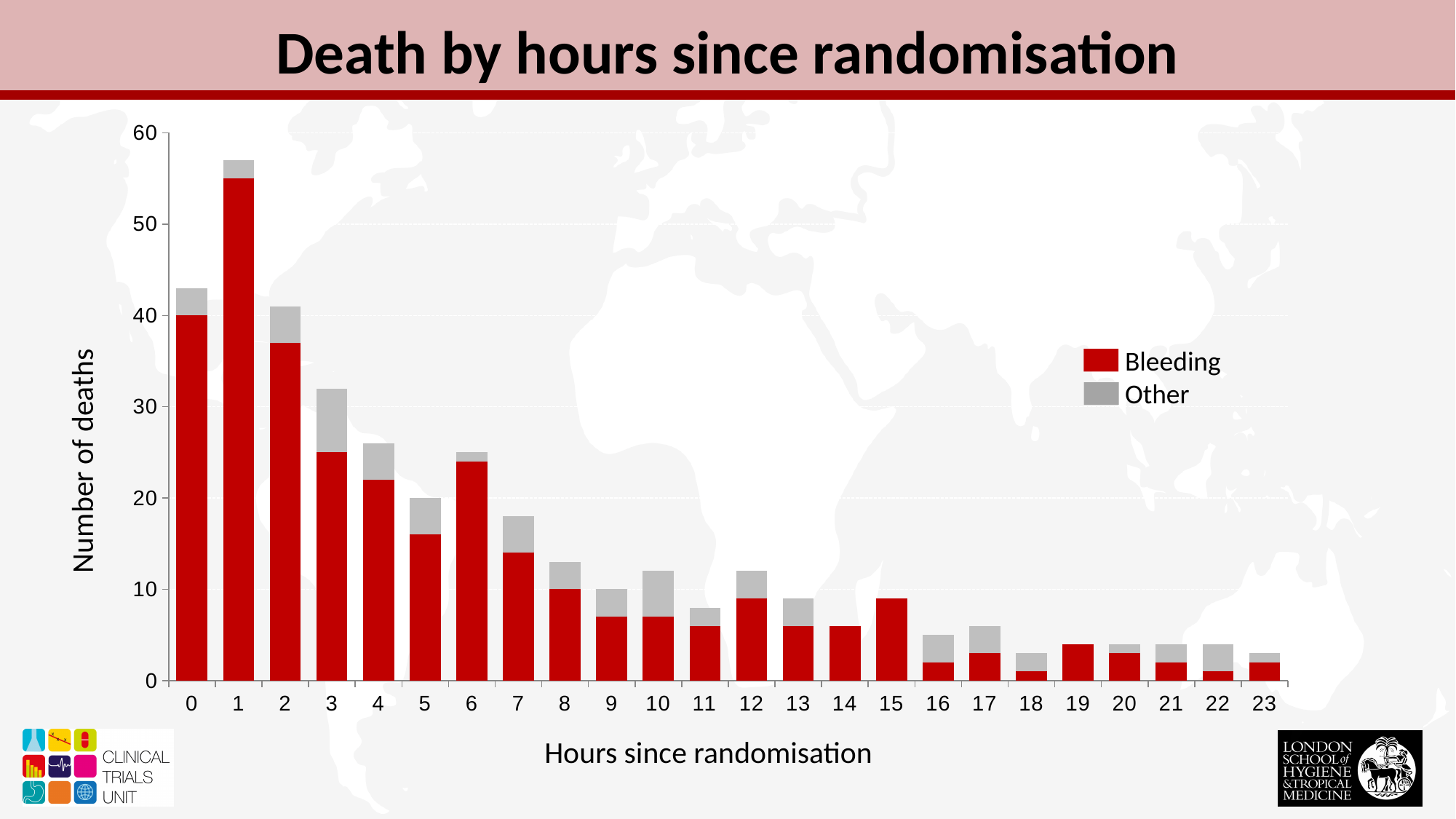
Which has more total deaths, hour 3 or hour 4? Hour 3 Is the total number of deaths at hour 16 greater or less than 10? less What kind of chart is shown on the slide? Stacked bar chart How many hour categories are shown on the x axis? 24 At which hour since randomisation is the total number of deaths highest? 1 Overall, do the number of deaths rise or fall as hours since randomisation increase? Fall Which colour represents the 'Other' series in the legend? Grey Is the total number of deaths at hour 3 greater or less than 30? greater Is the total number of deaths at hour 1 greater or less than 50? greater How many series does the legend list? 2